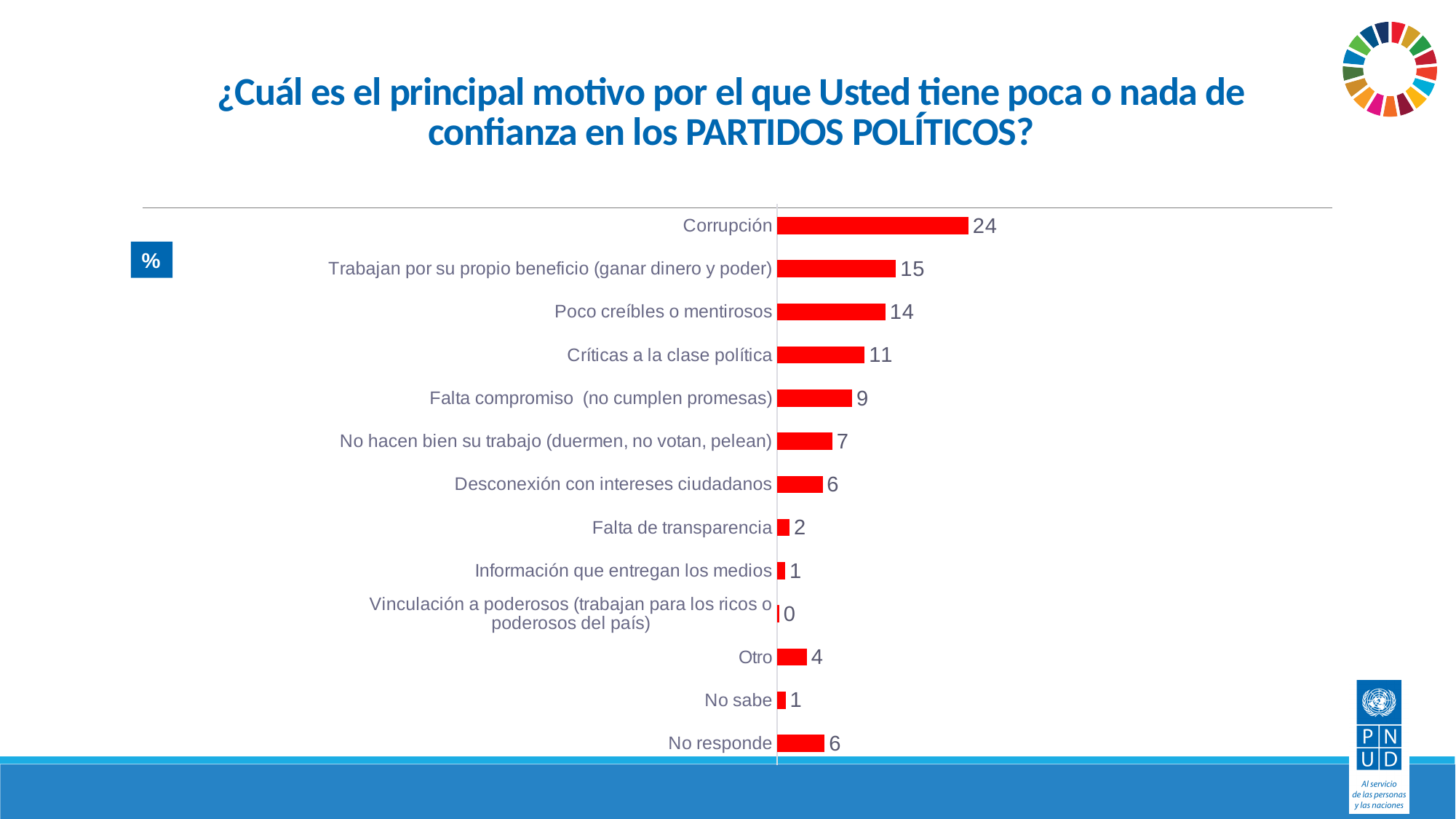
What is the value for Corrupción? 24 What is the difference between the values for Desconexión con intereses ciudadanos and Falta de transparencia? 4 What kind of chart is shown on the slide? Bar chart Which category has the lowest value? Vinculación a poderosos (trabajan para los ricos o poderosos del país) What is the value for Poco creíbles o mentirosos? 14 What is the value for Falta compromiso (no cumplen promesas)? 9 Which category has the highest value? Corrupción Which is larger, the value for Críticas a la clase política or the value for No hacen bien su trabajo (duermen, no votan, pelean)? Críticas a la clase política What is the value for Otro? 4 What is the difference between the values for Corrupción and Trabajan por su propio beneficio (ganar dinero y poder)? 9 What colour are the bars in the chart? Red How many categories are shown in the chart? 13